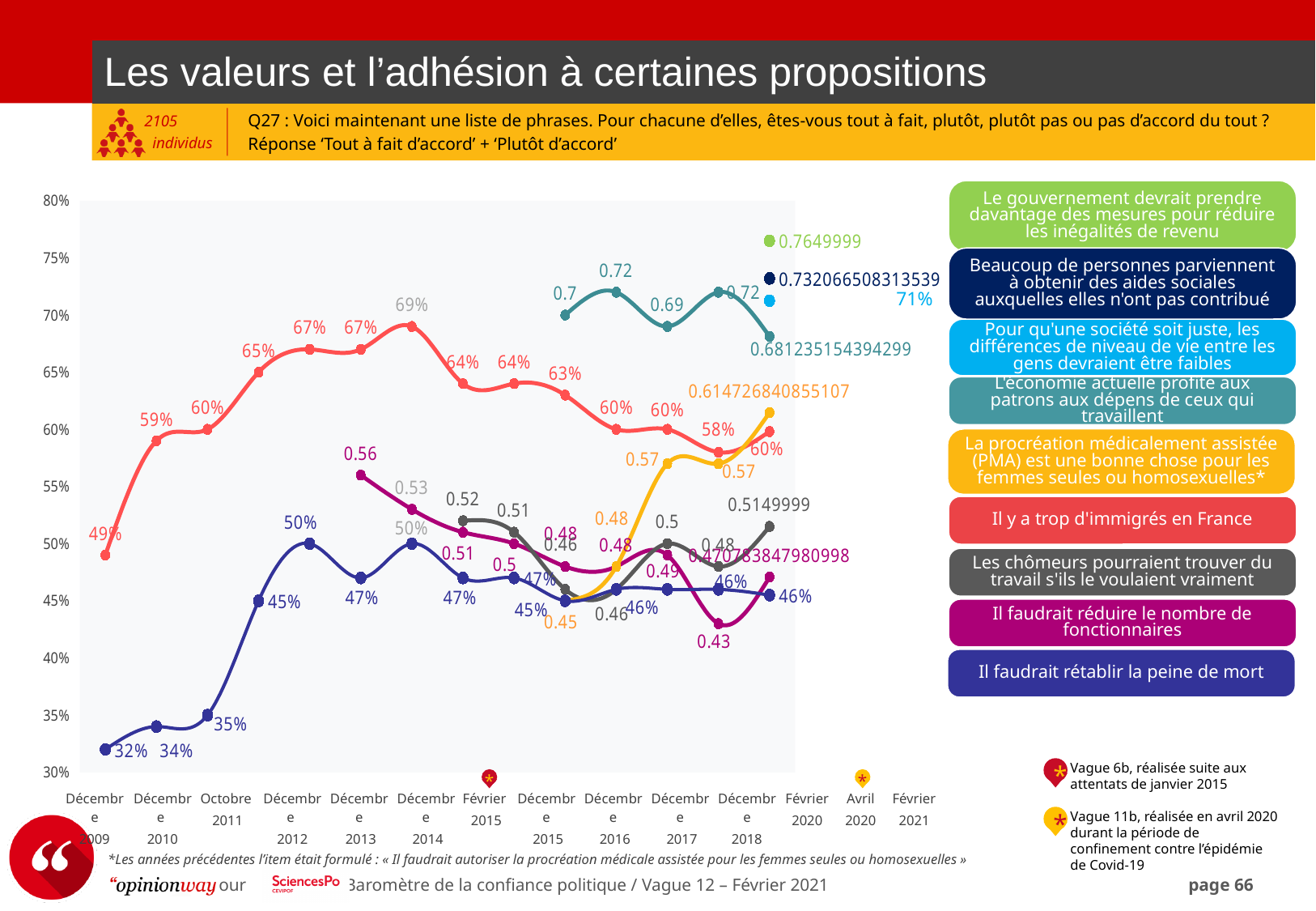
Does the 'Il faudrait rétablir la peine de mort' line rise or fall between Décembre 2009 and Décembre 2012? rise What is the value for 'Il y a trop d'immigrés en France' in Décembre 2009? 49% How many series does the legend on the right list? 9 What kind of chart is shown on the slide? line chart What value is shown for 'Le gouvernement devrait prendre davantage des mesures pour réduire les inégalités de revenu' in Février 2021? 0.7649999 What is the lowest value on the 'Il faudrait rétablir la peine de mort' line? 32% What is the difference between 'Il y a trop d'immigrés en France' and 'Il faudrait rétablir la peine de mort' in Décembre 2009? 17 percentage points What is the highest value reached by the 'Il y a trop d'immigrés en France' line? 69% What is the lowest value on the 'Il faudrait réduire le nombre de fonctionnaires' line? 0.43 What is the value for 'Il faudrait rétablir la peine de mort' in Décembre 2009? 32% How many time points are labelled along the x axis? 14 What value is shown for 'Pour qu'une société soit juste, les différences de niveau de vie entre les gens devraient être faibles' in Février 2021? 71%